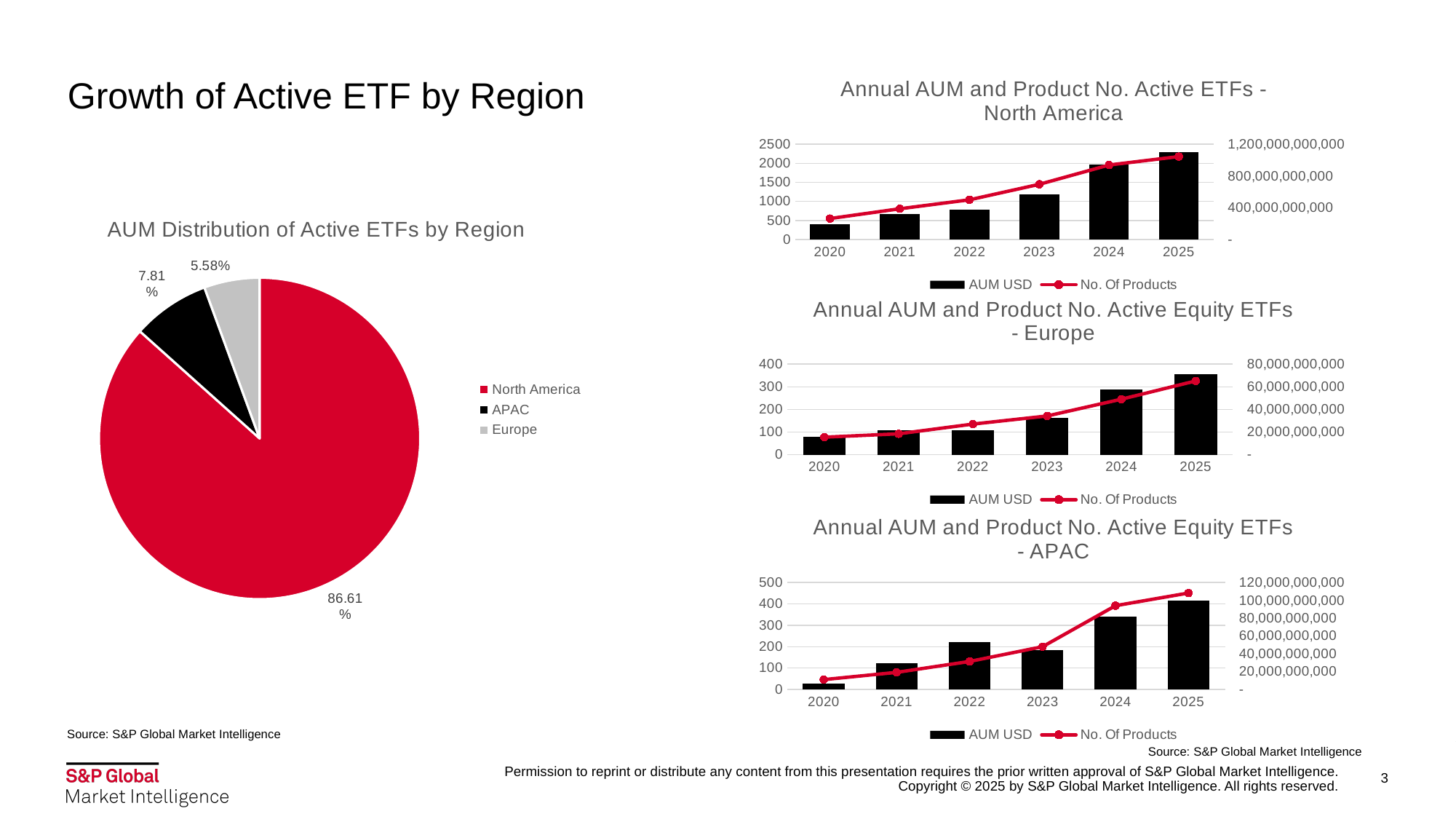
In the pie chart 'AUM Distribution of Active ETFs by Region', which region has the largest share? North America In the pie chart 'AUM Distribution of Active ETFs by Region', which region has the smallest share? Europe In the pie chart 'AUM Distribution of Active ETFs by Region', what share does Europe hold? 5.58% In the pie chart 'AUM Distribution of Active ETFs by Region', how many regions are shown? 3 In the pie chart 'AUM Distribution of Active ETFs by Region', what share does North America hold? 86.61% In the pie chart 'AUM Distribution of Active ETFs by Region', what share does APAC hold? 7.81% In the pie chart 'AUM Distribution of Active ETFs by Region', how many percentage points larger is APAC's share than Europe's? 2.23 percentage points In the chart 'Annual AUM and Product No. Active Equity ETFs - Europe', how many years are shown on the x axis? 6 What kind of chart is 'AUM Distribution of Active ETFs by Region'? Pie chart In the chart 'Annual AUM and Product No. Active Equity ETFs - APAC', does the No. Of Products line rise or fall from 2020 to 2025? Rise In the chart 'Annual AUM and Product No. Active ETFs - North America', how many series does the legend list? 2 In the chart 'Annual AUM and Product No. Active ETFs - North America', what colour are the AUM USD bars? Black